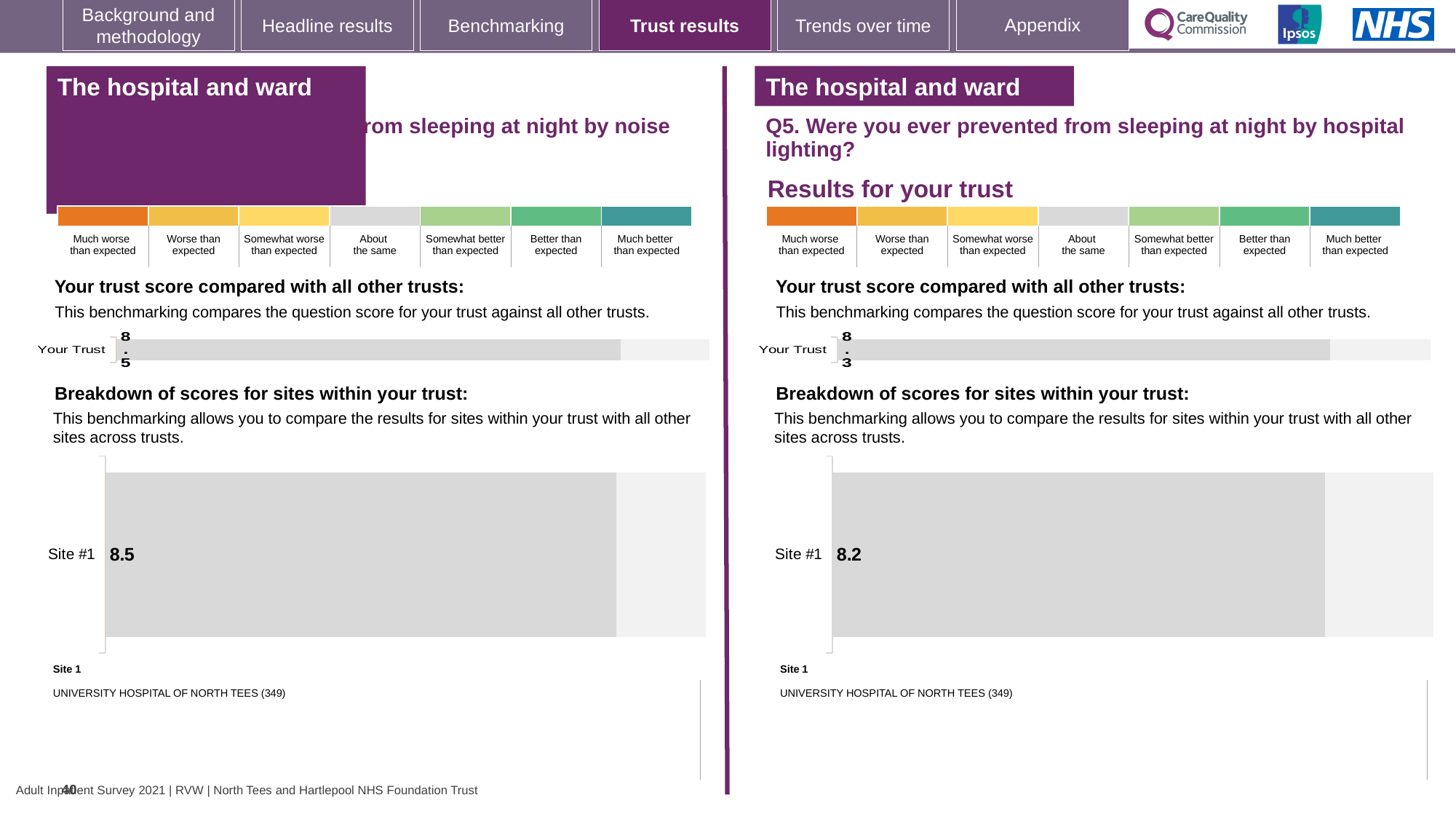
Which is larger: the Site #1 score in the left-hand breakdown chart or the Site #1 score in the right-hand breakdown chart? Left-hand chart (8.5) How many sites are plotted in the 'Breakdown of scores for sites within your trust' chart on the right half of the slide? 1 What is the difference between the Site #1 score on the left half of the slide and the Site #1 score on the right half of the slide? 0.3 What type of chart is used to show the Site #1 score in the breakdown charts? Bar chart How many rating categories are shown in the colour scale above the 'Your trust score compared with all other trusts' chart on the right half of the slide? 7 What is the difference between the Your Trust score on the left half of the slide and the Your Trust score on the right half of the slide? 0.2 On the right half of the slide (Q5, hospital lighting), what score is shown for Site #1 in the 'Breakdown of scores for sites within your trust' chart? 8.2 On the right half of the slide, which is larger: the Your Trust score or the Site #1 score? Your Trust (8.3) On the left half of the slide, what score is shown for Site #1 in the 'Breakdown of scores for sites within your trust' chart? 8.5 On the left half of the slide, what is the score shown for Your Trust in the 'Your trust score compared with all other trusts' chart? 8.5 Which site is listed as Site 1 beneath the breakdown chart on the right half of the slide? UNIVERSITY HOSPITAL OF NORTH TEES (349) On the right half of the slide (Q5, hospital lighting), what is the score shown for Your Trust in the 'Your trust score compared with all other trusts' chart? 8.3